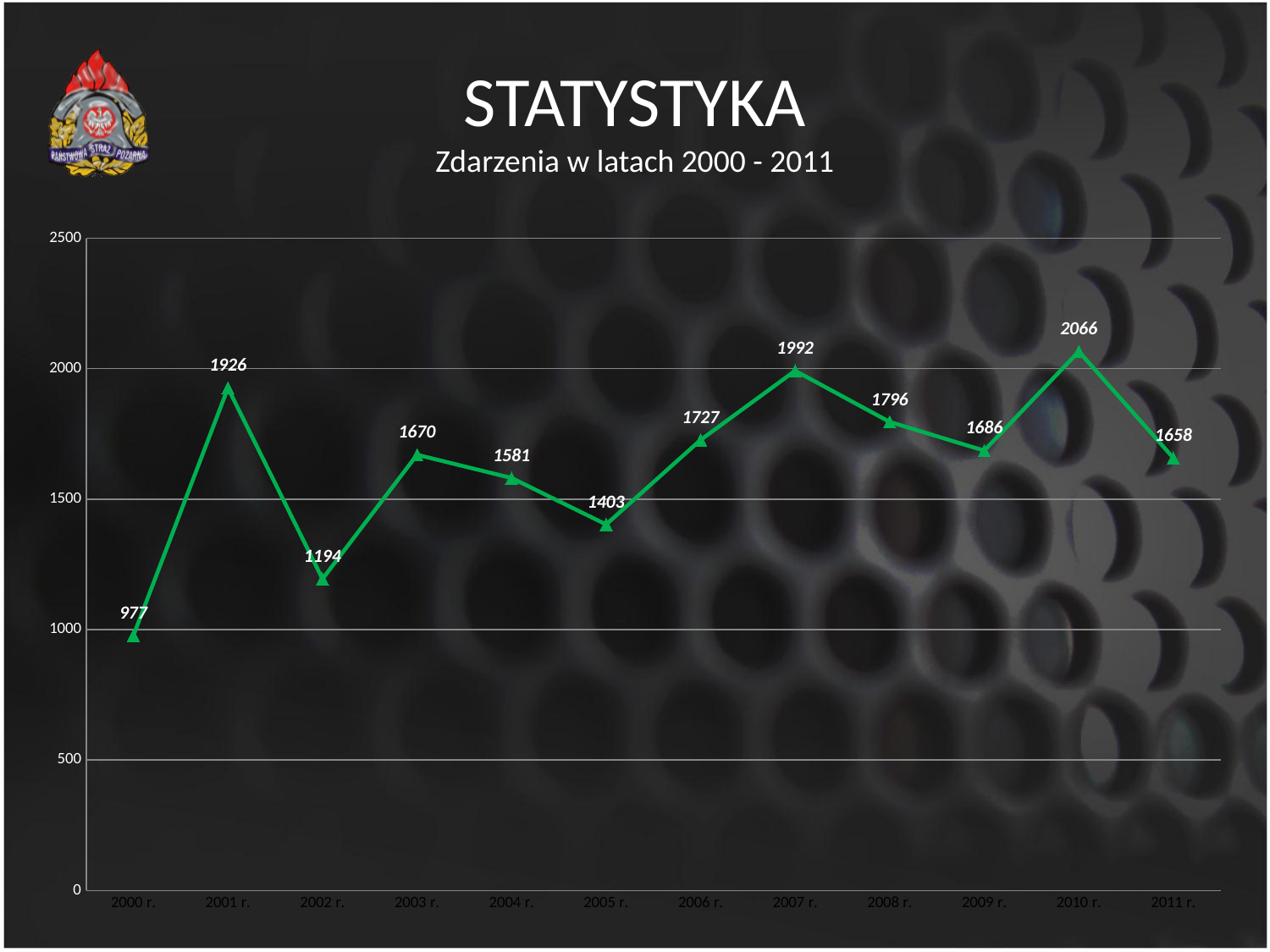
What is the difference between the values for 2010 r. and 2011 r.? 408 What kind of chart is shown on the slide? line chart Which is larger, the value for 2003 r. or the value for 2004 r.? 2003 r. What is the difference between the values for 2001 r. and 2002 r.? 732 What is the value for 2005 r.? 1403 How many years are plotted on the chart? 12 What is the subtitle of the chart? Zdarzenia w latach 2000 - 2011 What is the value for 2008 r.? 1796 Which year has the lowest value? 2000 r. Is the value for 2007 r. greater or less than 1500? greater Which year has the highest value? 2010 r. What is the value for 2001 r.? 1926